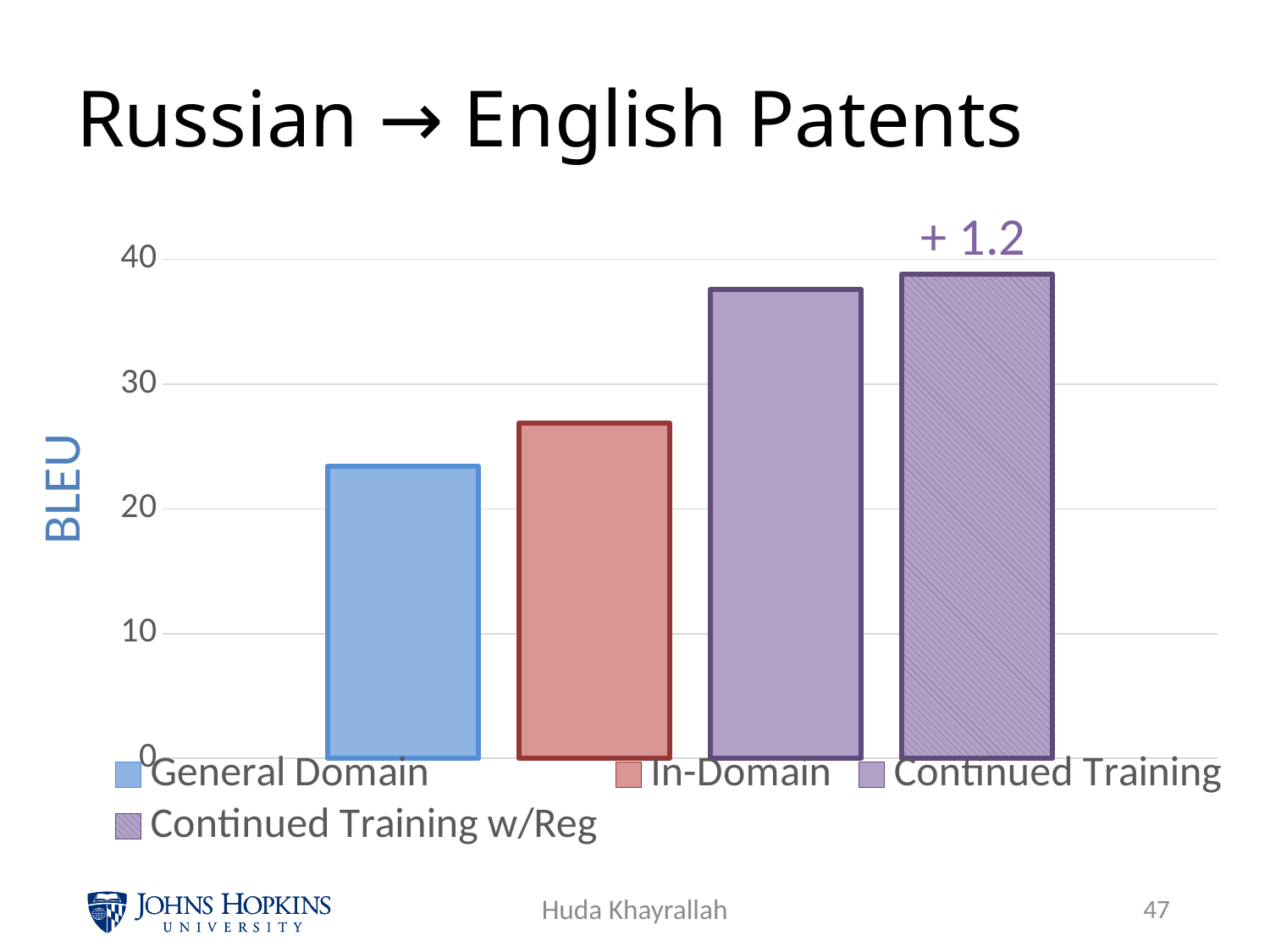
What annotation is printed above the Continued Training w/Reg bar? + 1.2 Is the BLEU value for In-Domain greater or less than 30? less Is the BLEU value for Continued Training greater or less than 30? greater How many series does the legend list? 4 Is the BLEU value for Continued Training w/Reg greater or less than 40? less What kind of chart is shown on the slide? bar chart Which series has the lowest BLEU score? General Domain Which has a higher BLEU score, General Domain or In-Domain? In-Domain Do the BLEU values rise or fall from left to right across the bars? rise Which series has the highest BLEU score? Continued Training w/Reg Which has a higher BLEU score, In-Domain or Continued Training? Continued Training